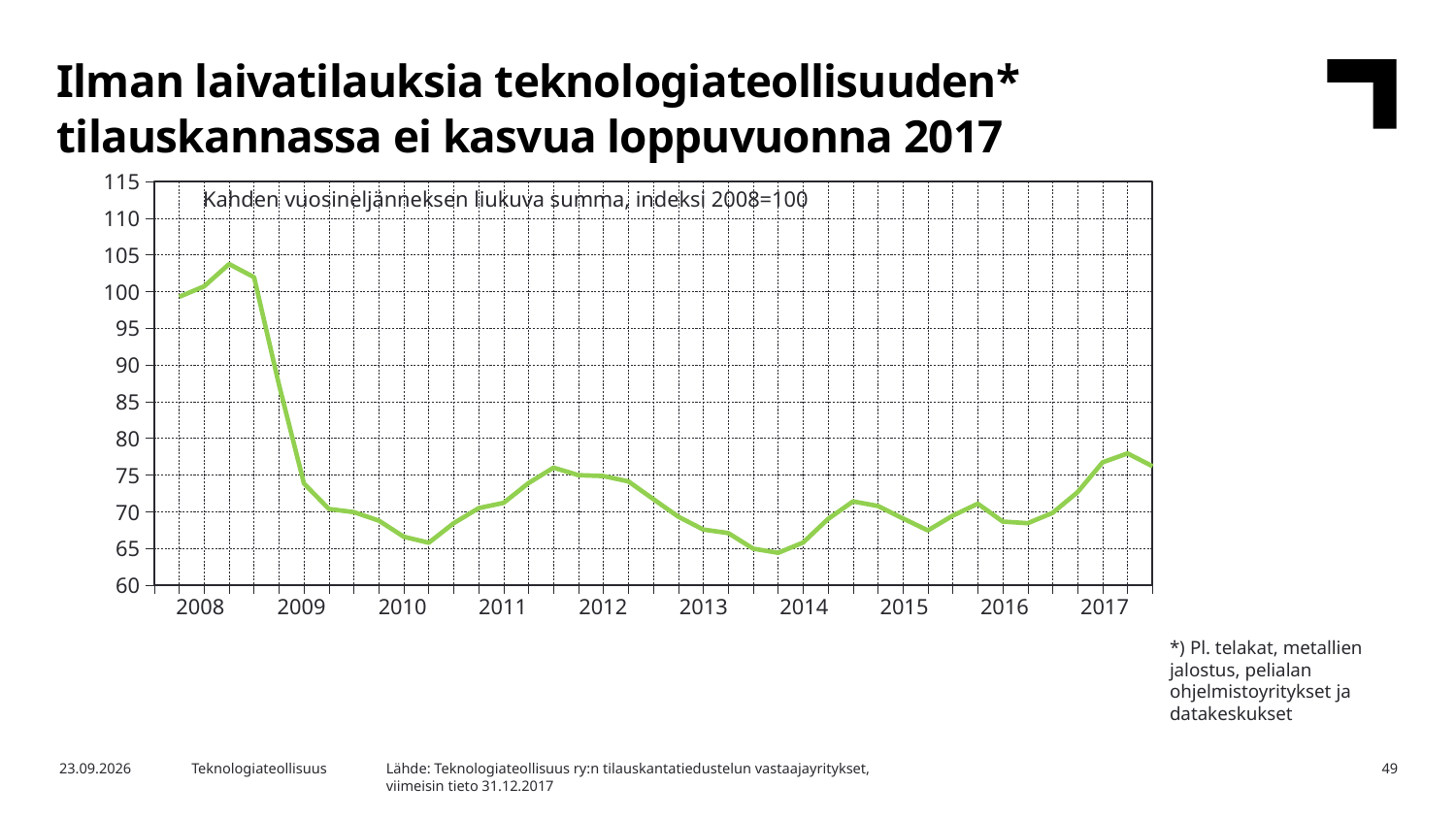
In which year does the line reach its highest value? 2008 Does the line rise or fall between 2008 and 2009? fall How many data series are plotted in the chart? 1 In which year does the line reach its lowest value? 2014 Is the value at the end of 2017 greater or less than 70? greater Is the peak value in 2008 greater or less than 100? greater What is the title printed inside the chart area? Kahden vuosineljänneksen liukuva summa, indeksi 2008=100 Is the lowest value in 2013 greater or less than 70? less How many year labels are shown on the x axis? 10 Does the line rise or fall between 2016 and 2017? rise What kind of chart is shown on the slide? line chart